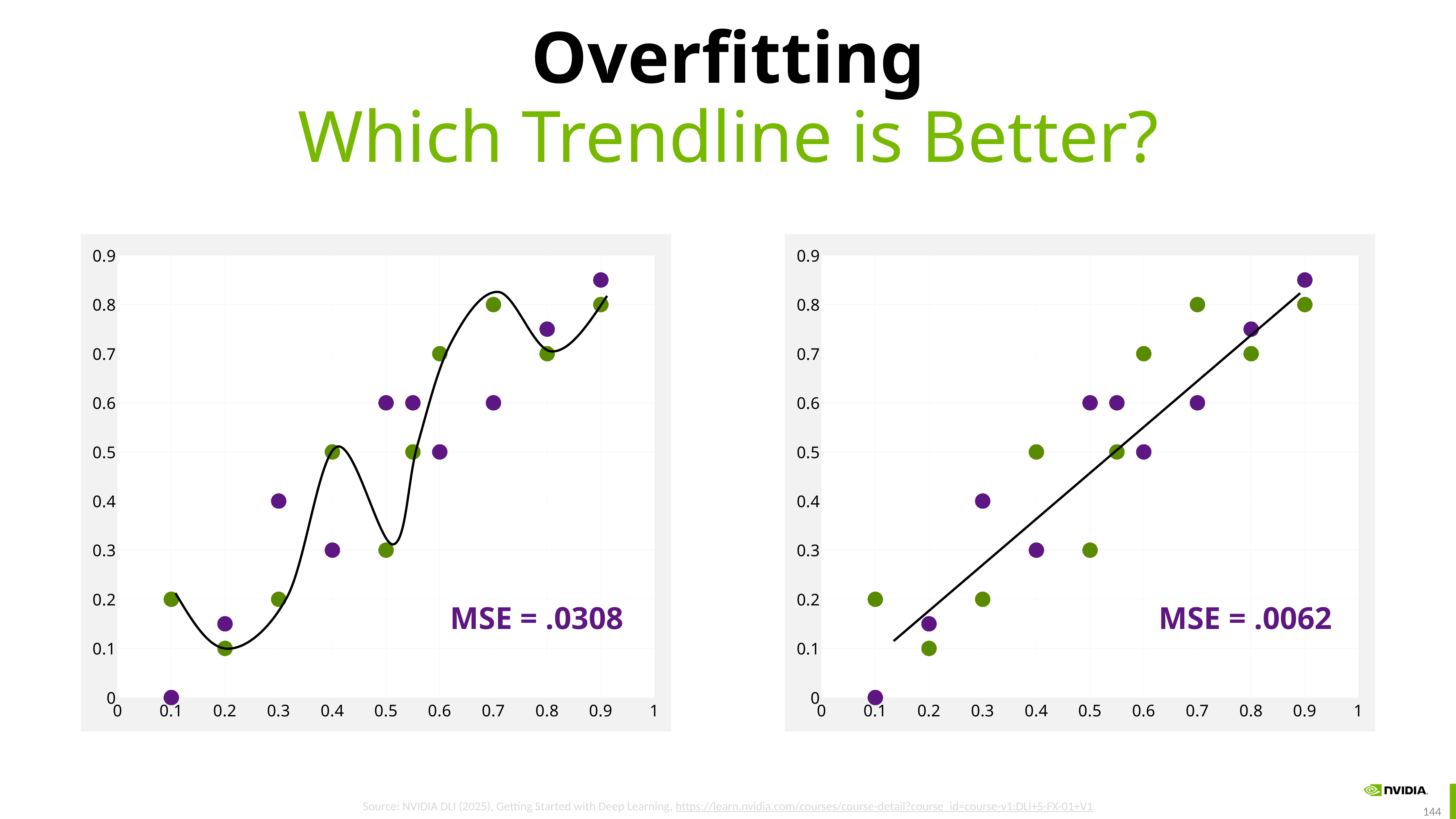
On the left chart, which point has the highest y value? the purple point at x = 0.9 On the right chart, do the y values generally rise or fall as x increases? rise On the left chart, what MSE value is printed? MSE = .0308 On the left chart, what is the y value of the purple point at x = 0.1? 0 On the right chart, is the y value of the purple point at x = 0.9 greater or less than 0.8? greater What kind of chart is the left chart? scatter chart On the right chart, what MSE value is printed? MSE = .0062 On the right chart, what is the y value of the green point at x = 0.1? 0.2 On the left chart, is the y value of the purple point at x = 0.2 greater or less than 0.2? less On the left chart, which is larger: the y value of the green point at x = 0.4 or the green point at x = 0.5? the green point at x = 0.4 On the left chart, what is the y value of the green point at x = 0.7? 0.8 On the right chart, what is the y value of the purple point at x = 0.3? 0.4